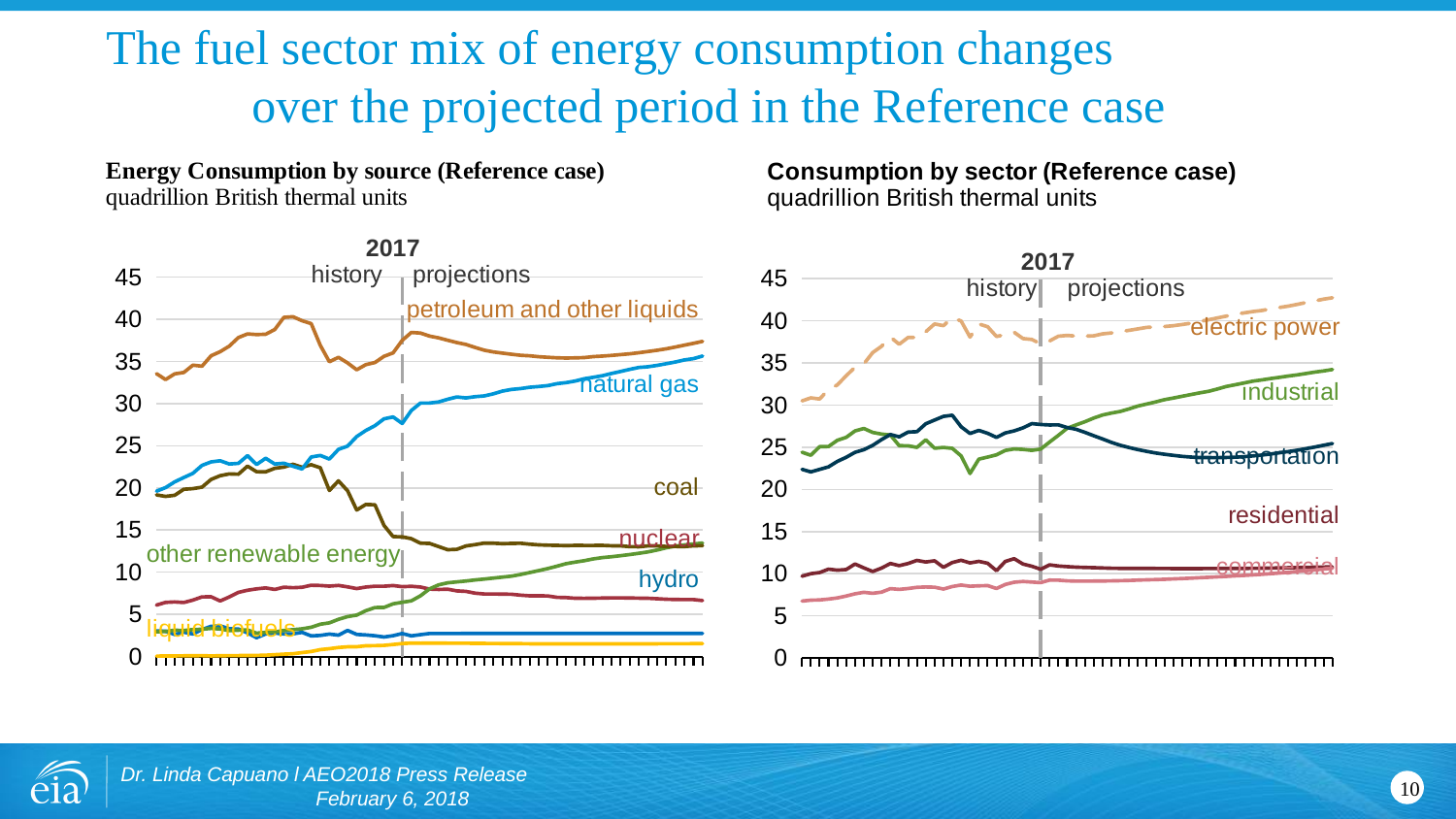
How many labelled series are plotted on the 'Consumption by sector (Reference case)' chart on the right? 5 On the left chart, does natural gas consumption rise or fall over the projection period? rise On the left chart, which source has the highest consumption at the end of the projection period? petroleum and other liquids What kind of chart is the 'Energy Consumption by source (Reference case)' chart on the left? line chart How many labelled series are plotted on the 'Energy Consumption by source (Reference case)' chart on the left? 7 On the left chart, is the value for coal at the end of the projection period greater or less than 15? less On the right chart, which sector has the highest consumption at the end of the projection period? electric power On the left chart, is the value for natural gas at the end of the projection period greater or less than 30? greater What year does the vertical dashed line separating history from projections mark on both charts? 2017 On the left chart, which source has the lowest consumption at the end of the projection period? liquid biofuels On the right chart, does transportation consumption rise or fall over the projection period? fall On the right chart, is the value for electric power at the end of the projection period greater or less than 40? greater